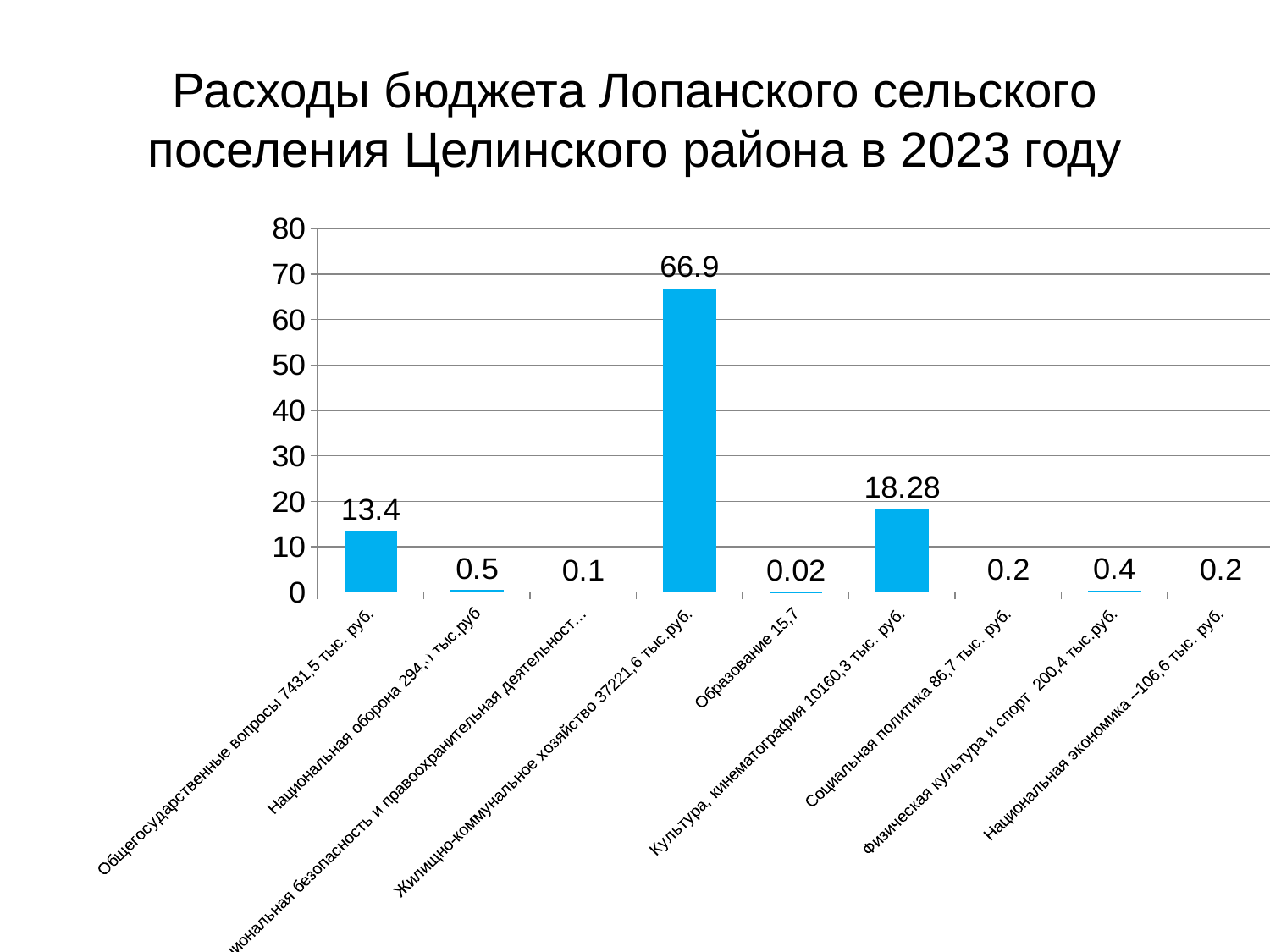
How many categories are shown on the chart? 9 What is the value shown for Общегосударственные вопросы? 13.4 What is the value shown for Культура, кинематография? 18.28 Is the value for Жилищно-коммунальное хозяйство greater or less than 60? greater Which category has the highest value? Жилищно-коммунальное хозяйство What kind of chart is shown on the slide? bar chart Which category has the lowest value? Образование Which is larger, the value for Общегосударственные вопросы or the value for Культура, кинематография? Культура, кинематография What is the value shown for Физическая культура и спорт? 0.4 What is the value shown for Жилищно-коммунальное хозяйство? 66.9 What is the difference between the values for Жилищно-коммунальное хозяйство and Культура, кинематография? 48.62 What is the value shown for Образование? 0.02